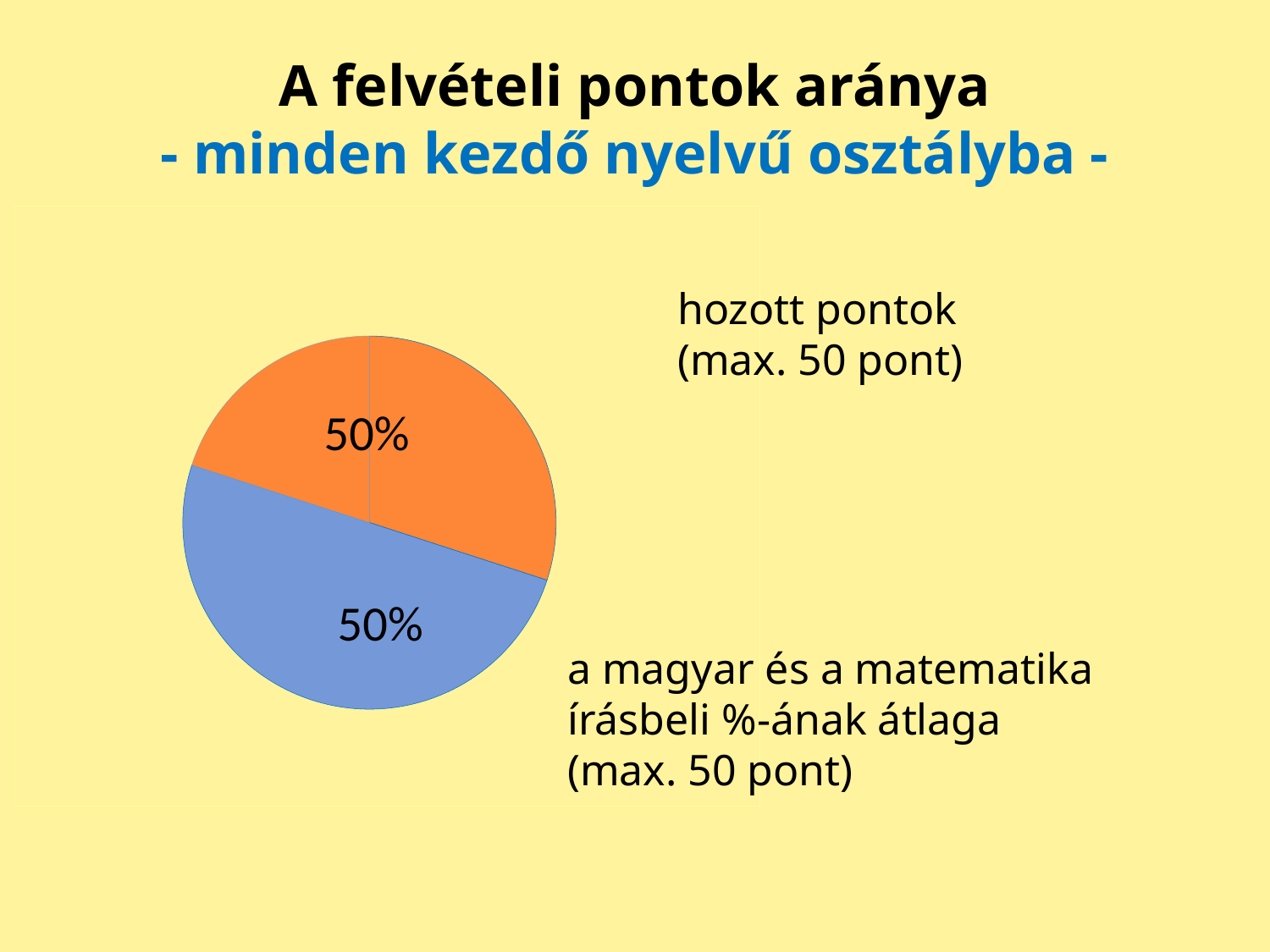
How many slices does the pie chart have? 3 What share of the pie does the "a magyar és a matematika írásbeli %-ának átlaga" slice represent? 50% What do the two slice percentages add up to? 100% What is the difference between the two slices' percentages? 0% What is the maximum number of points stated for "hozott pontok"? 50 pont What colour is the "hozott pontok" slice? orange Is the "hozott pontok" slice larger, smaller, or the same size as the "a magyar és a matematika írásbeli %-ának átlaga" slice? the same size What share of the pie does the "hozott pontok" slice represent? 50% What kind of chart is shown on the slide? pie chart What is the title of the slide containing the pie chart? A felvételi pontok aránya - minden kezdő nyelvű osztályba -